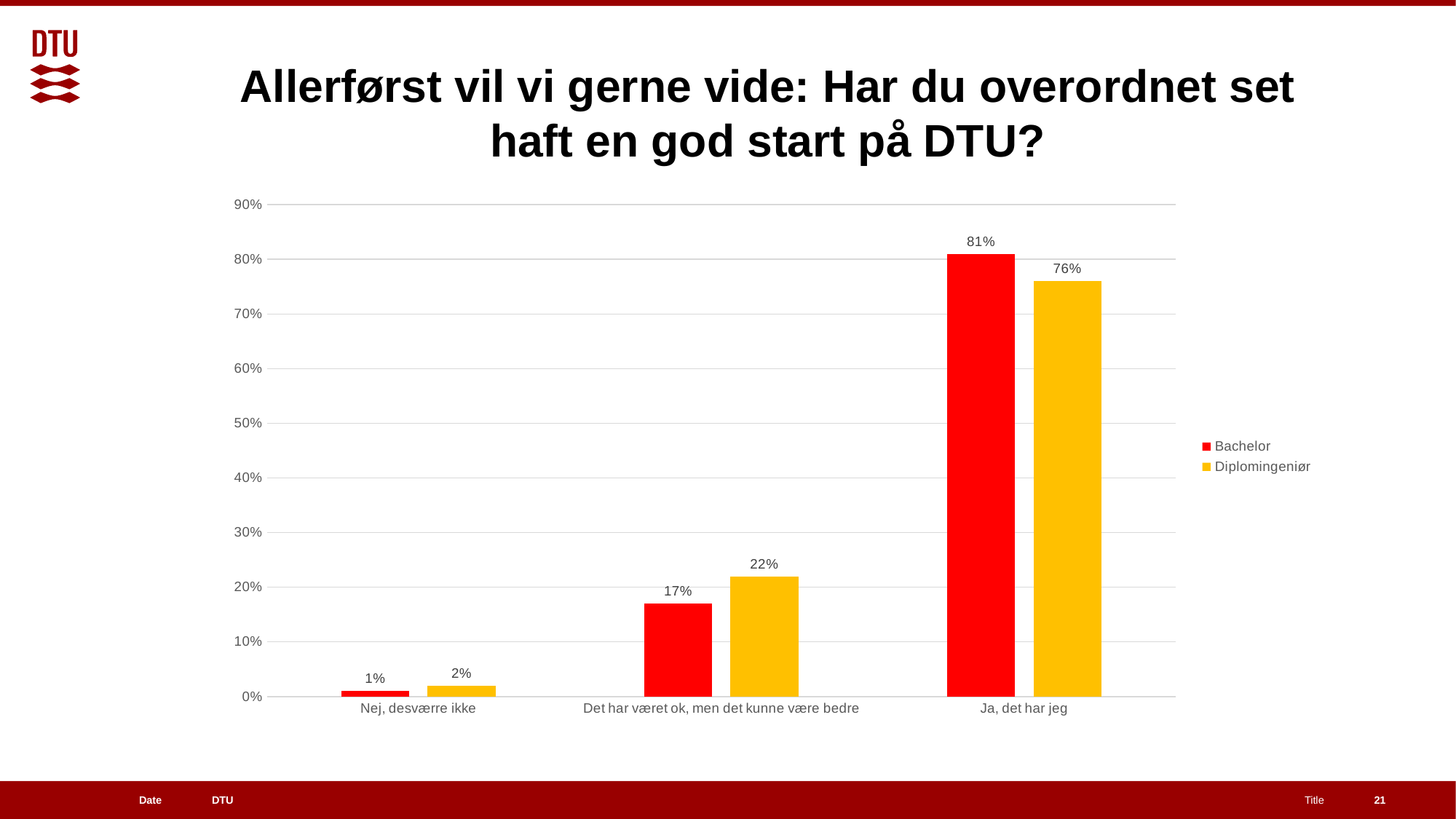
What is the Diplomingeniør value for "Det har været ok, men det kunne være bedre"? 22% What is the Bachelor value for "Ja, det har jeg"? 81% How many categories are shown on the x axis? 3 How many series does the legend list? 2 What is the difference between the Bachelor and Diplomingeniør values for "Ja, det har jeg"? 5% Which category has the highest Bachelor value? Ja, det har jeg What kind of chart is shown on the slide? Bar chart For "Det har været ok, men det kunne være bedre", which series has the larger value, Bachelor or Diplomingeniør? Diplomingeniør What is the Diplomingeniør value for "Nej, desværre ikke"? 2% Is the Diplomingeniør value for "Ja, det har jeg" greater or less than 70%? greater Which category has the lowest Diplomingeniør value? Nej, desværre ikke What is the difference between the Diplomingeniør and Bachelor values for "Det har været ok, men det kunne være bedre"? 5%